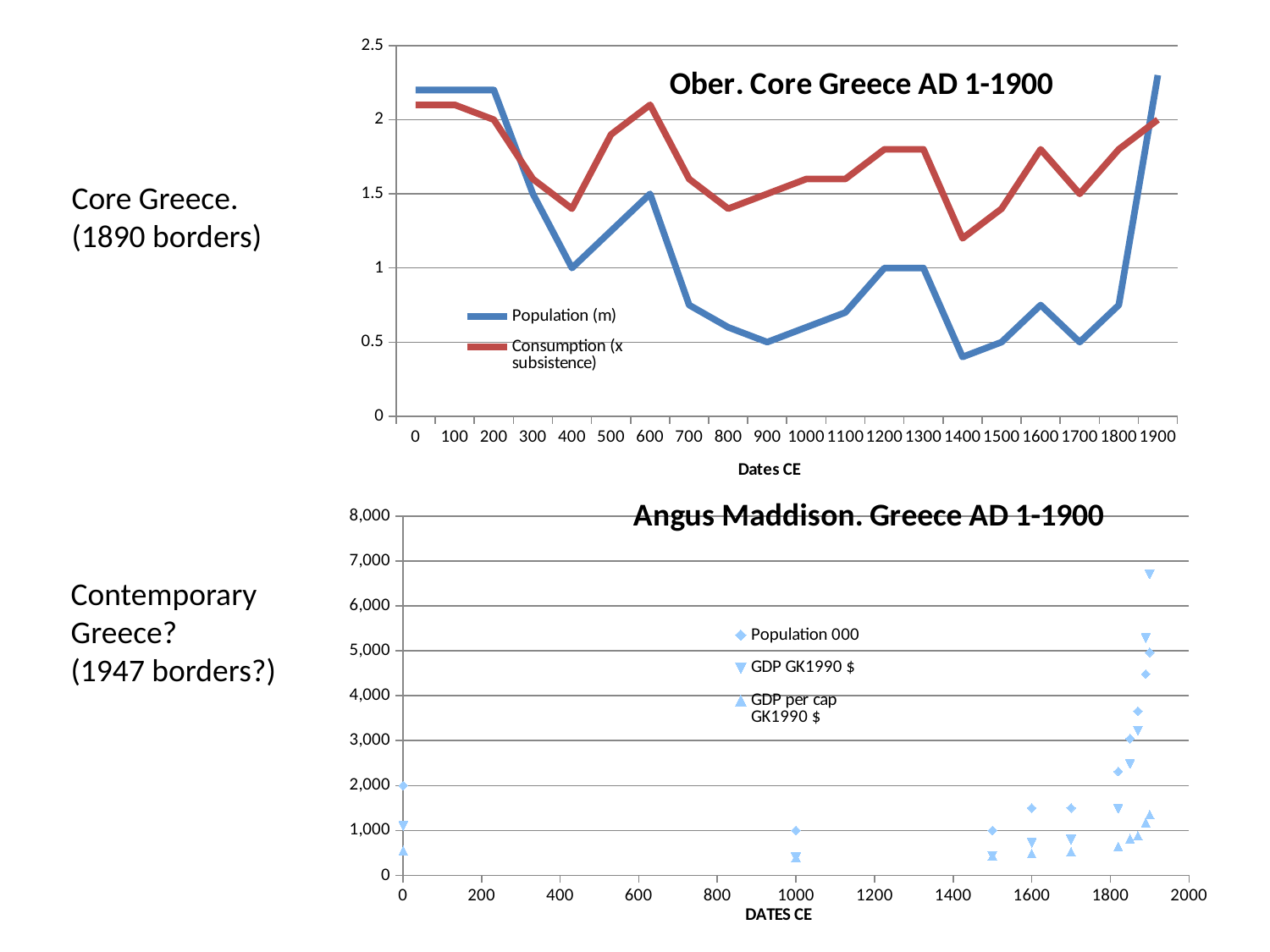
In the bottom chart 'Angus Maddison. Greece AD 1-1900', how many series does the legend list? 3 In the top chart 'Ober. Core Greece AD 1-1900', what kind of chart is it? line chart In the top chart 'Ober. Core Greece AD 1-1900', does Population (m) rise or fall between 200 CE and 400 CE? fall In the bottom chart 'Angus Maddison. Greece AD 1-1900', what is the Population 000 value at 0 CE? 2,000 In the top chart 'Ober. Core Greece AD 1-1900', how many series does the legend list? 2 In the top chart 'Ober. Core Greece AD 1-1900', which is larger at 600 CE, Population (m) or Consumption (x subsistence)? Consumption (x subsistence) In the top chart 'Ober. Core Greece AD 1-1900', at which date is Population (m) lowest? 1400 In the top chart 'Ober. Core Greece AD 1-1900', is the Consumption (x subsistence) value at 1400 CE greater or less than 1.5? less In the top chart 'Ober. Core Greece AD 1-1900', what is the Population (m) value at 900 CE? 0.5 In the top chart 'Ober. Core Greece AD 1-1900', at which date is Population (m) highest? 1900 In the top chart 'Ober. Core Greece AD 1-1900', what is the Population (m) value at 400 CE? 1 In the bottom chart 'Angus Maddison. Greece AD 1-1900', is the GDP GK1990 $ value at 1900 CE greater or less than 6,000? greater